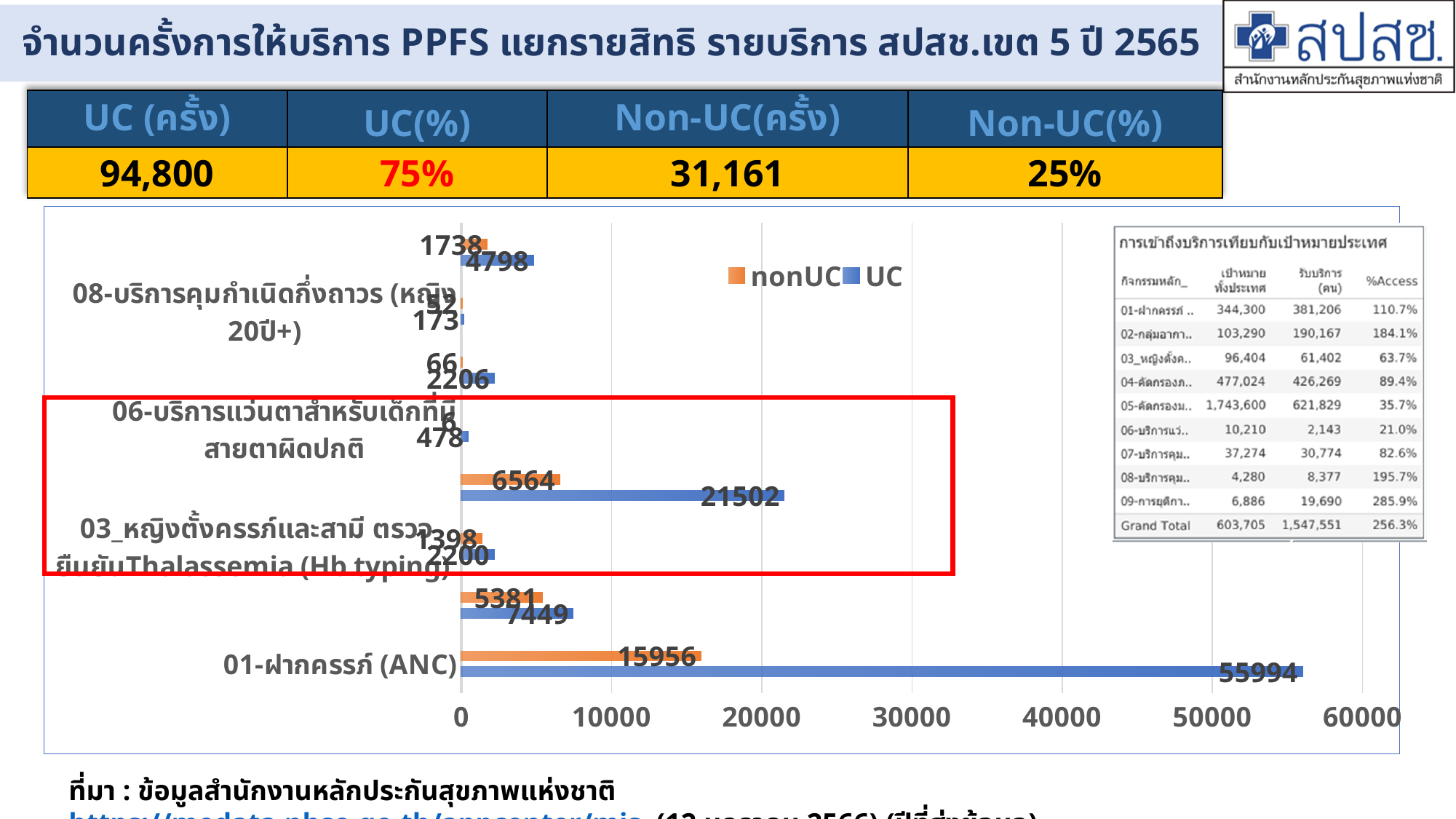
How many series does the chart legend list? 2 Which category has the highest UC value? 01-ฝากครรภ์ (ANC) What is the UC value for 01-ฝากครรภ์ (ANC)? 55994 What is the nonUC value for 03_หญิงตั้งครรภ์และสามี ตรวจยืนยันThalassemia (Hb typing)? 1398 What is the difference between the UC and nonUC values for 01-ฝากครรภ์ (ANC)? 40038 What is the nonUC value for 01-ฝากครรภ์ (ANC)? 15956 Is the UC value for 01-ฝากครรภ์ (ANC) greater or less than 50000? greater What is the UC value for 06-บริการแว่นตาสำหรับเด็กที่มีสายตาผิดปกติ? 478 What kind of chart is shown on the slide? bar chart For 01-ฝากครรภ์ (ANC), which is larger, the UC value or the nonUC value? UC Which colour represents the nonUC series in the chart? orange What is the difference between the UC and nonUC values for 03_หญิงตั้งครรภ์และสามี ตรวจยืนยันThalassemia (Hb typing)? 802